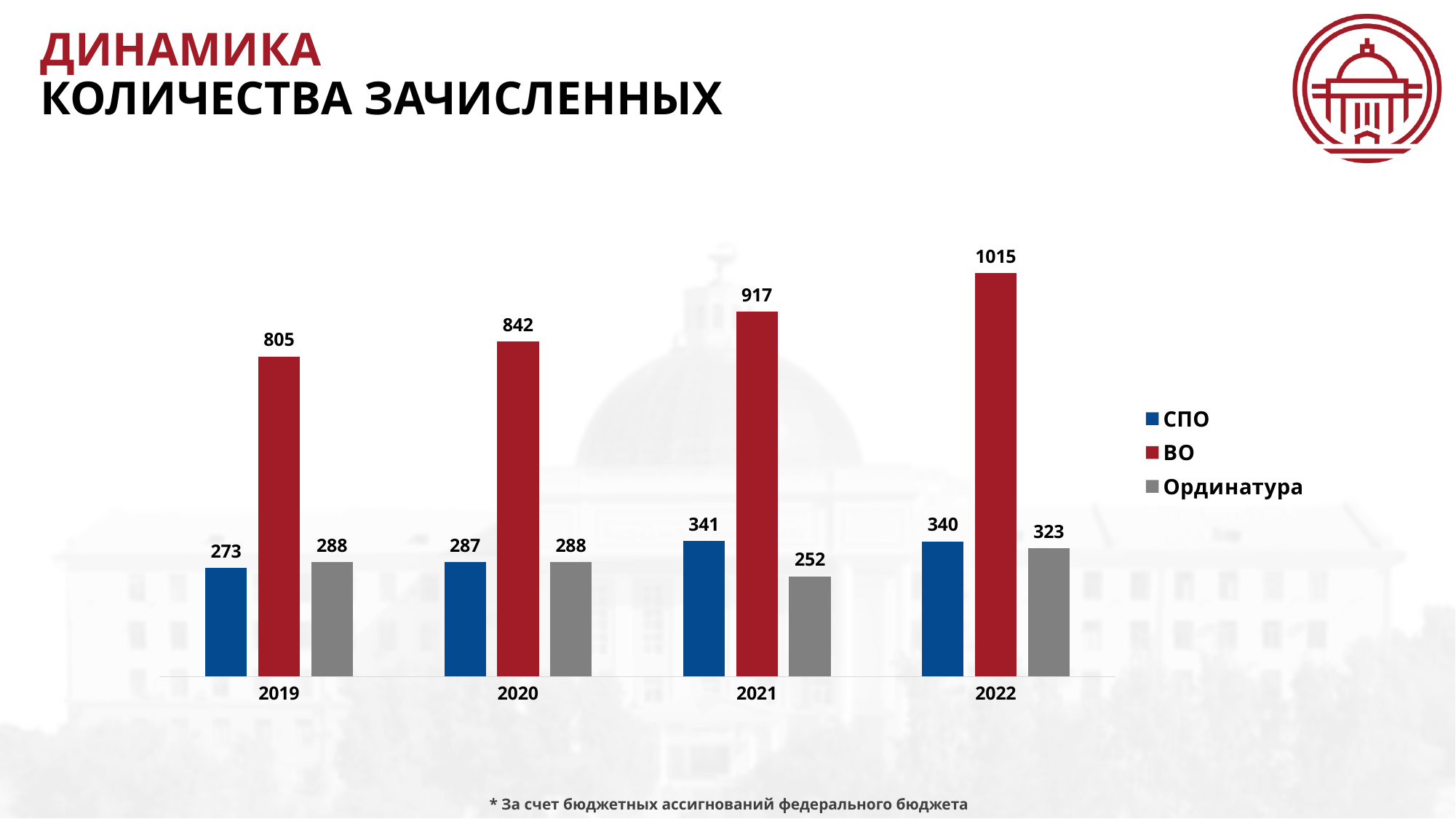
What kind of chart is shown on the slide? Bar chart Which colour represents the ВО series in the legend? Red How many series does the legend list? 3 Does the ВО series rise or fall from 2019 to 2022? Rise In which year is the ВО value highest? 2022 What is the value for Ординатура in 2021? 252 In which year is the Ординатура value lowest? 2021 How many years are shown on the x axis? 4 What is the difference between the ВО values for 2022 and 2019? 210 Which is larger in 2020: the value for СПО or the value for Ординатура? Ординатура What is the value for ВО in 2022? 1015 What is the value for СПО in 2019? 273